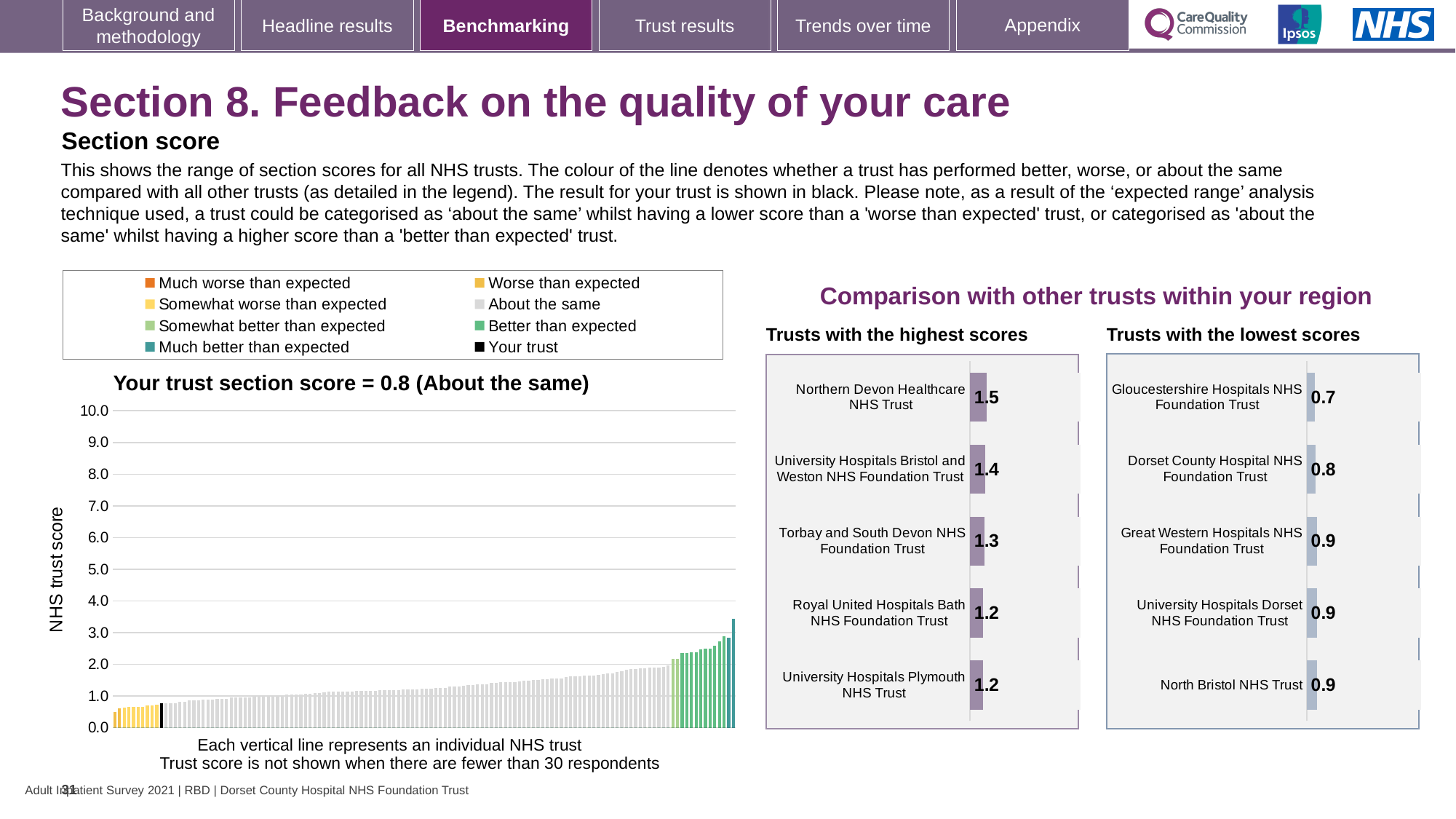
How many trusts are shown in the 'Trusts with the lowest scores' chart? 5 In the 'Trusts with the highest scores' chart, what is the score for Northern Devon Healthcare NHS Trust? 1.5 In the 'Trusts with the highest scores' chart, what is the score for Torbay and South Devon NHS Foundation Trust? 1.3 In the main chart 'Your trust section score = 0.8 (About the same)', is the tallest bar greater or less than 5.0? less In the 'Trusts with the lowest scores' chart, which trust has the lowest score? Gloucestershire Hospitals NHS Foundation Trust In the main chart 'Your trust section score = 0.8 (About the same)', do the bar values rise or fall from left to right? rise In the 'Trusts with the lowest scores' chart, what is the score for Gloucestershire Hospitals NHS Foundation Trust? 0.7 In the 'Trusts with the highest scores' chart, which has the larger score: University Hospitals Bristol and Weston NHS Foundation Trust or Royal United Hospitals Bath NHS Foundation Trust? University Hospitals Bristol and Weston NHS Foundation Trust In the 'Trusts with the highest scores' chart, what is the difference between the scores of Northern Devon Healthcare NHS Trust and University Hospitals Plymouth NHS Trust? 0.3 According to the main chart's title, what is your trust's section score? 0.8 In the 'Trusts with the lowest scores' chart, what is the score for Dorset County Hospital NHS Foundation Trust? 0.8 In the 'Trusts with the highest scores' chart, which trust has the highest score? Northern Devon Healthcare NHS Trust